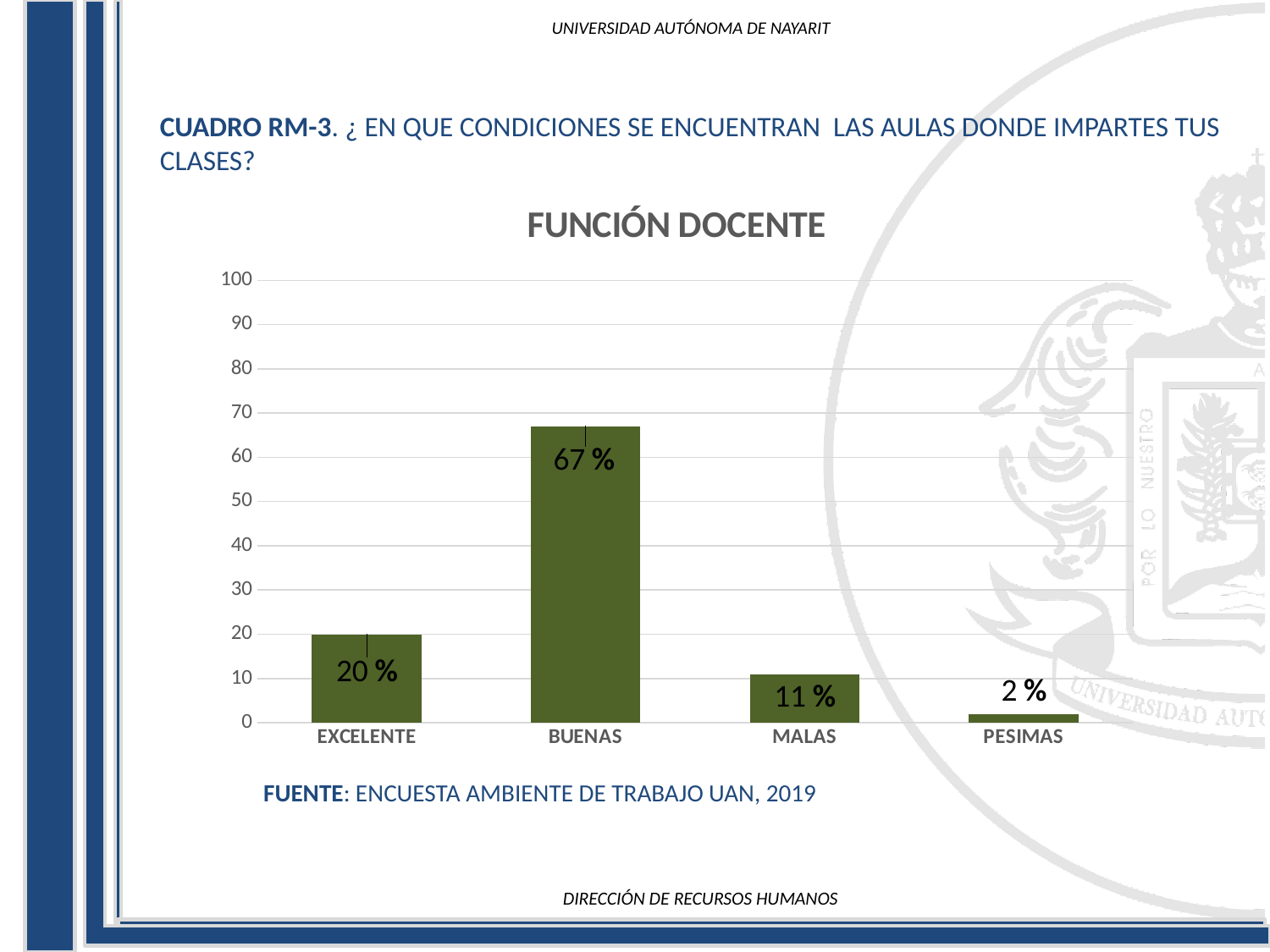
Which category has the lowest value? PESIMAS Which is larger, the value for EXCELENTE or the value for MALAS? EXCELENTE What is the value for BUENAS? 67 % How many categories are shown on the x axis? 4 Which category has the highest value? BUENAS What is the difference between the values for BUENAS and EXCELENTE? 47 % What is the value for PESIMAS? 2 % What is the title of the chart? FUNCIÓN DOCENTE Is the value for BUENAS greater or less than 50? greater What is the value for EXCELENTE? 20 % What is the value for MALAS? 11 % What kind of chart is shown? bar chart